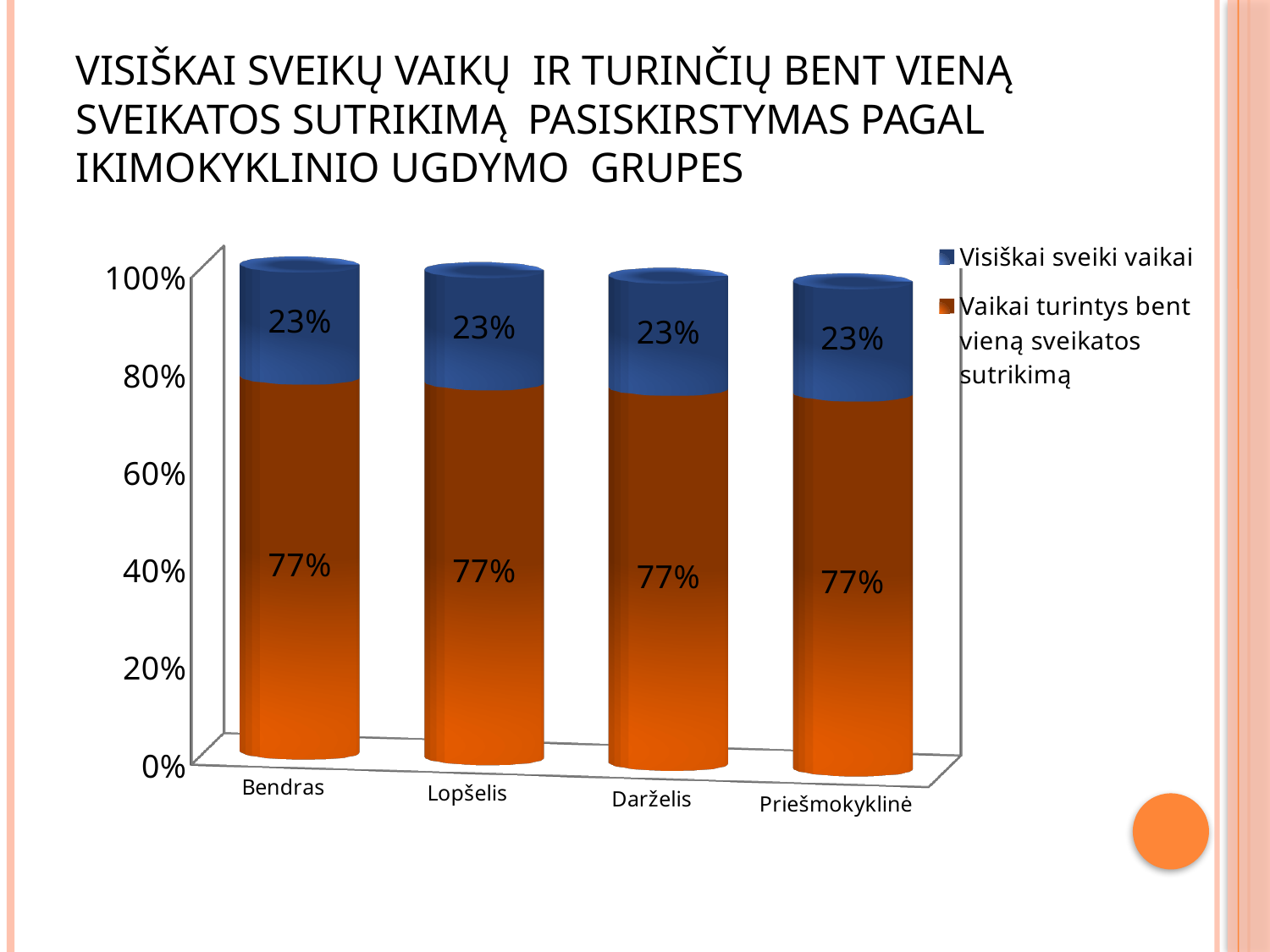
What kind of chart is shown on the slide? Stacked bar chart Do the 'Visiškai sveiki vaikai' values rise, fall, or stay the same across the groups from Bendras to Priešmokyklinė? Stay the same What is the value of the 'Visiškai sveiki vaikai' segment for the Priešmokyklinė group? 23% In the Darželis group, what is the difference in percentage points between children with at least one health disorder and completely healthy children? 54 percentage points In the Bendras group, which is larger: the share of completely healthy children or the share of children with at least one health disorder? Children with at least one health disorder (77%) What is the value of the 'Vaikai turintys bent vieną sveikatos sutrikimą' segment for the Darželis group? 77% How many groups (categories) are shown on the x axis of the chart? 4 Which colour represents 'Visiškai sveiki vaikai' in the chart? Blue What is the total of the stacked bar for the Lopšelis group? 100% What percentage of children in the Bendras group are shown as 'Visiškai sveiki vaikai'? 23% How many series does the chart legend list? 2 What percentage of children in the Lopšelis group have at least one health disorder ('Vaikai turintys bent vieną sveikatos sutrikimą')? 77%